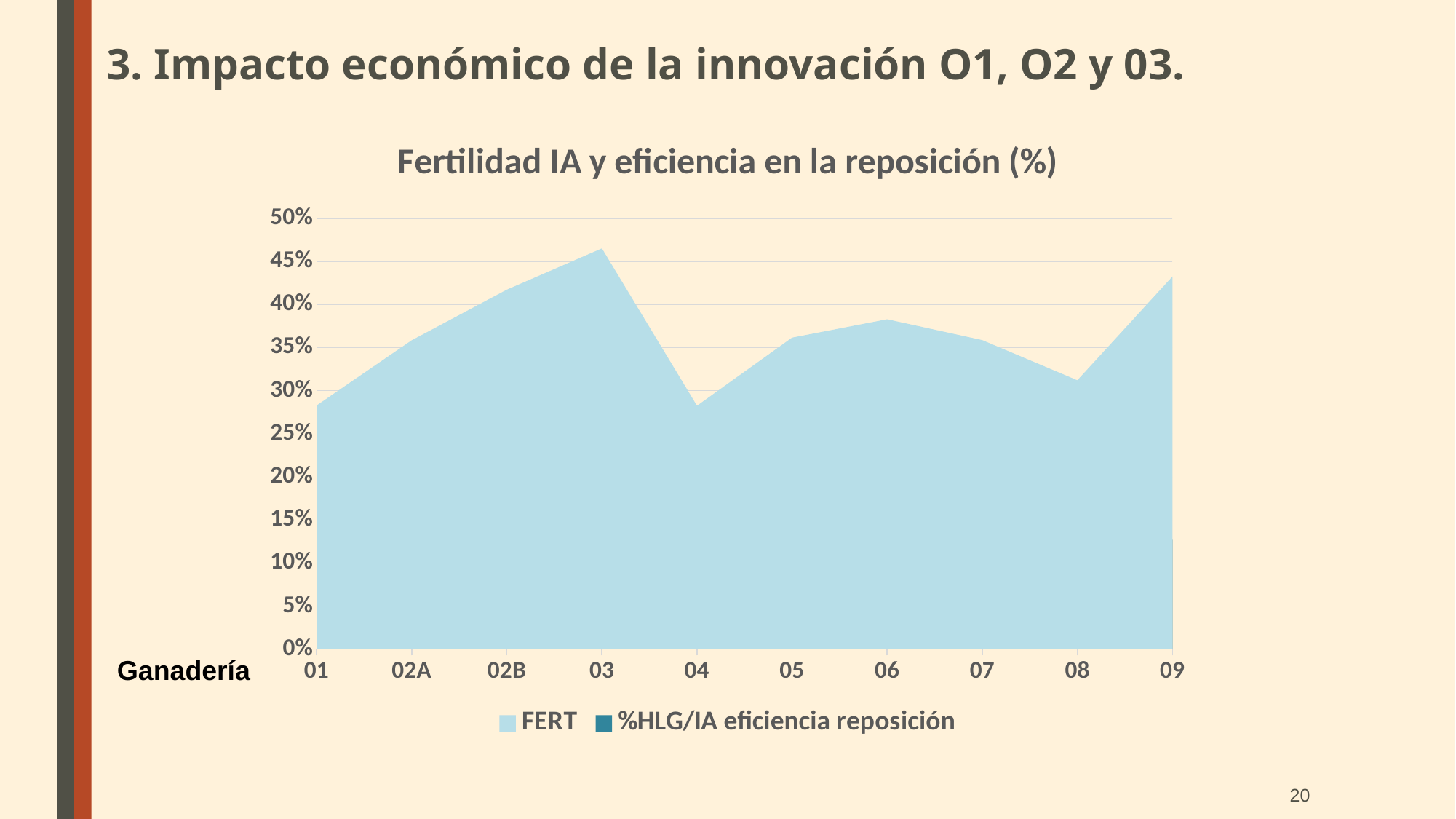
What kind of chart is shown on the slide? Area chart Is the FERT value for ganadería 01 greater or less than 30%? less How many categories (ganaderías) are shown along the x axis? 10 Is the FERT value for ganadería 03 greater or less than 40%? greater How many series does the chart legend list? 2 Which ganadería has the highest FERT value? 03 What is the title of the chart? Fertilidad IA y eficiencia en la reposición (%) Is the FERT value for ganadería 08 greater or less than 35%? less What are the two series names listed in the legend? FERT and %HLG/IA eficiencia reposición Does the FERT value rise or fall from ganadería 01 to ganadería 03? rise Which has a higher FERT value, ganadería 03 or ganadería 04? 03